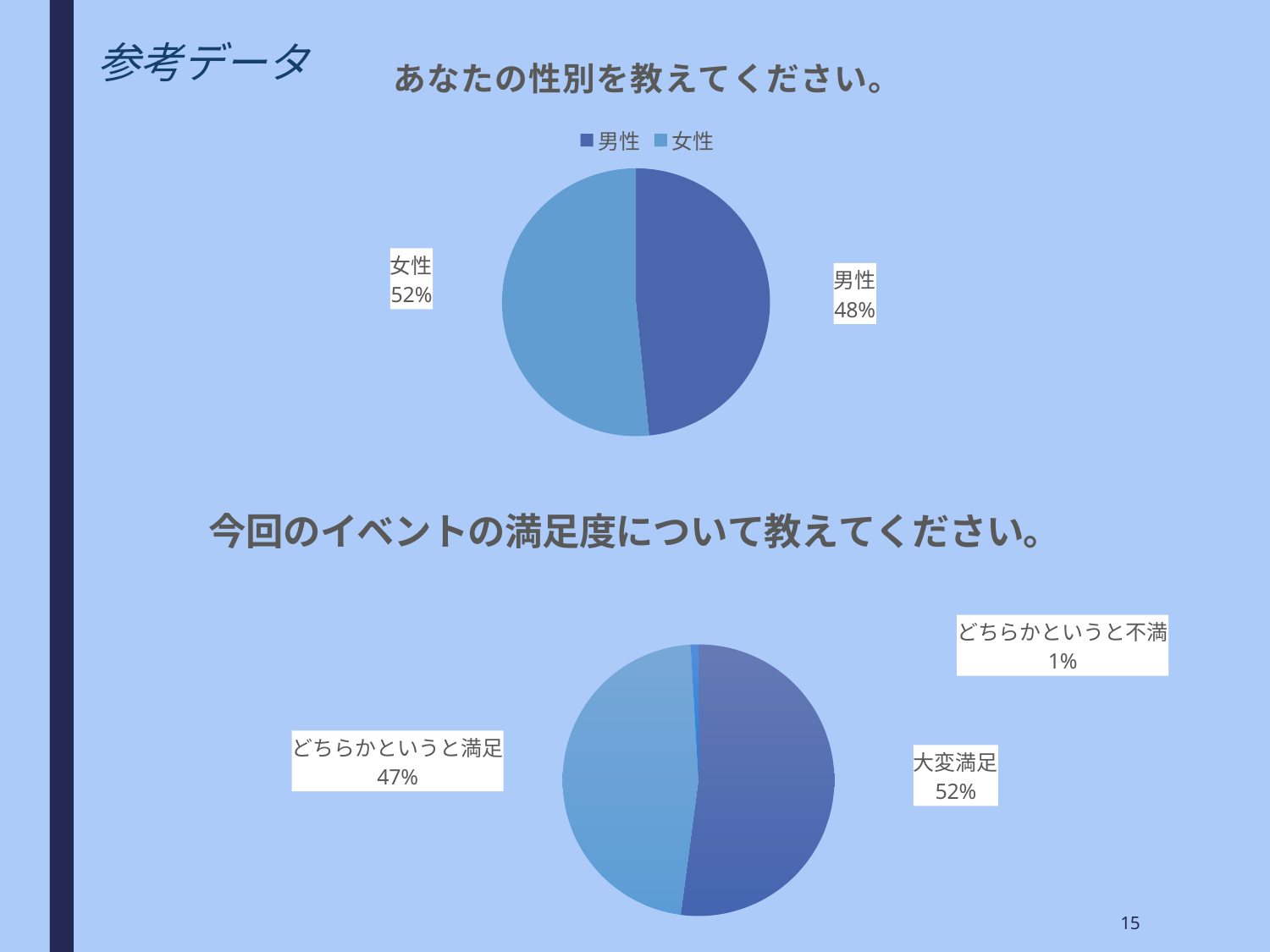
In the bottom chart (今回のイベントの満足度について教えてください。), which category has the smallest share? どちらかというと不満 In the bottom chart (今回のイベントの満足度について教えてください。), how many categories are shown? 3 In the bottom chart (今回のイベントの満足度について教えてください。), what share of respondents answered どちらかというと不満? 1% In the top chart (あなたの性別を教えてください。), what share of respondents are 男性? 48% In the top chart (あなたの性別を教えてください。), what share of respondents are 女性? 52% In the bottom chart (今回のイベントの満足度について教えてください。), what share of respondents answered どちらかというと満足? 47% In the top chart (あなたの性別を教えてください。), what is the difference in percentage points between 女性 and 男性? 4% What kind of chart is the top chart (あなたの性別を教えてください。)? Pie chart In the bottom chart (今回のイベントの満足度について教えてください。), what is the difference in percentage points between 大変満足 and どちらかというと満足? 5% In the bottom chart (今回のイベントの満足度について教えてください。), what share of respondents answered 大変満足? 52% In the top chart (あなたの性別を教えてください。), which category has the larger share? 女性 In the top chart (あなたの性別を教えてください。), how many entries does the legend list? 2